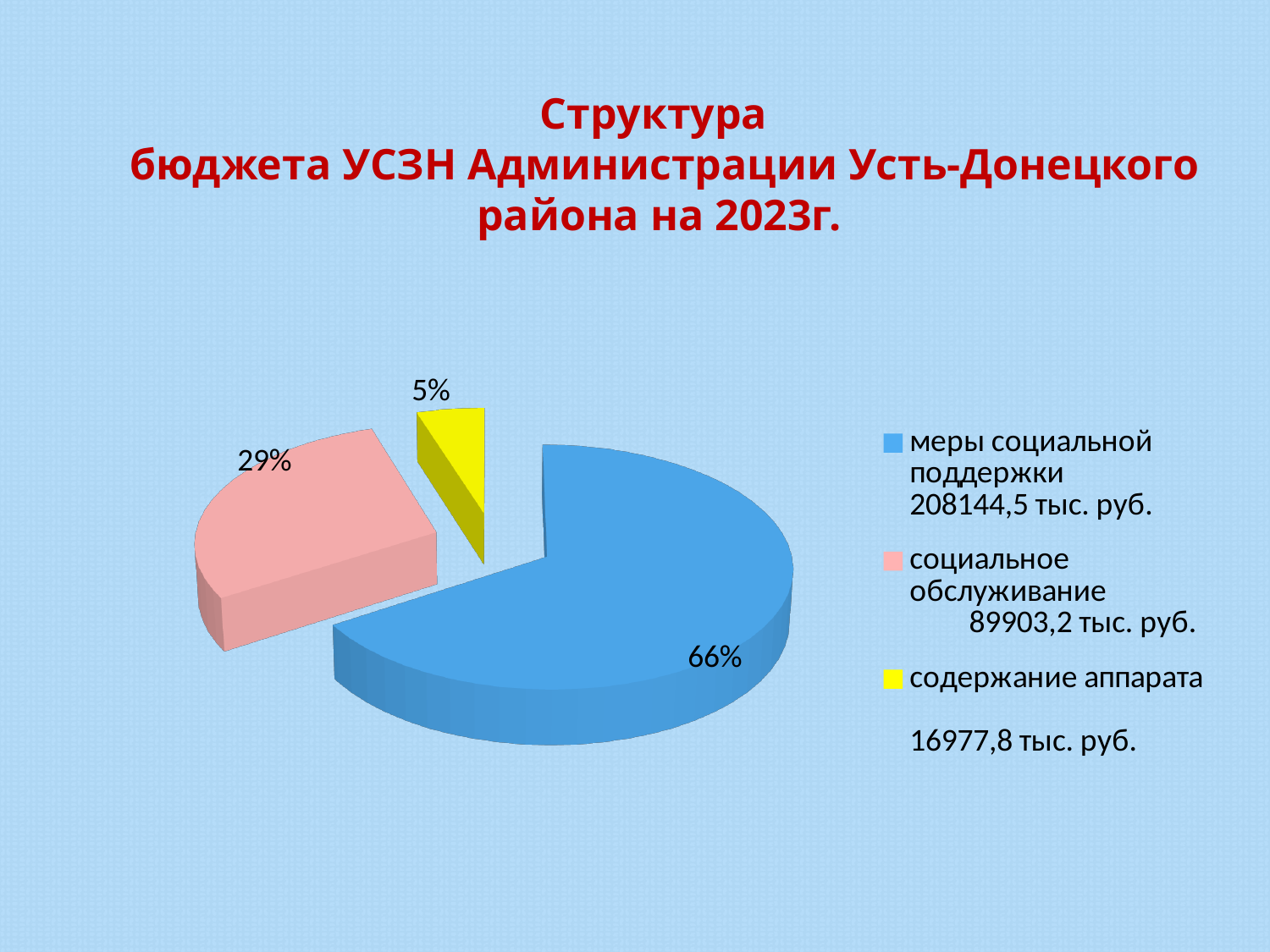
What share of the pie does "меры социальной поддержки" take? 66% What amount in thousand rubles is listed in the legend for "содержание аппарата"? 16977,8 тыс. руб. What colour is the slice for "социальное обслуживание"? pink What amount in thousand rubles is listed in the legend for "меры социальной поддержки"? 208144,5 тыс. руб. What share of the pie does "социальное обслуживание" take? 29% How many slices does the pie chart have? 3 What kind of chart is shown on the slide? pie chart What share of the pie does "содержание аппарата" take? 5% What is the difference in percentage points between the "меры социальной поддержки" slice and the "социальное обслуживание" slice? 37 Which is larger: the share for "социальное обслуживание" or for "содержание аппарата"? социальное обслуживание Which category has the largest slice of the pie? меры социальной поддержки Which category has the smallest slice of the pie? содержание аппарата